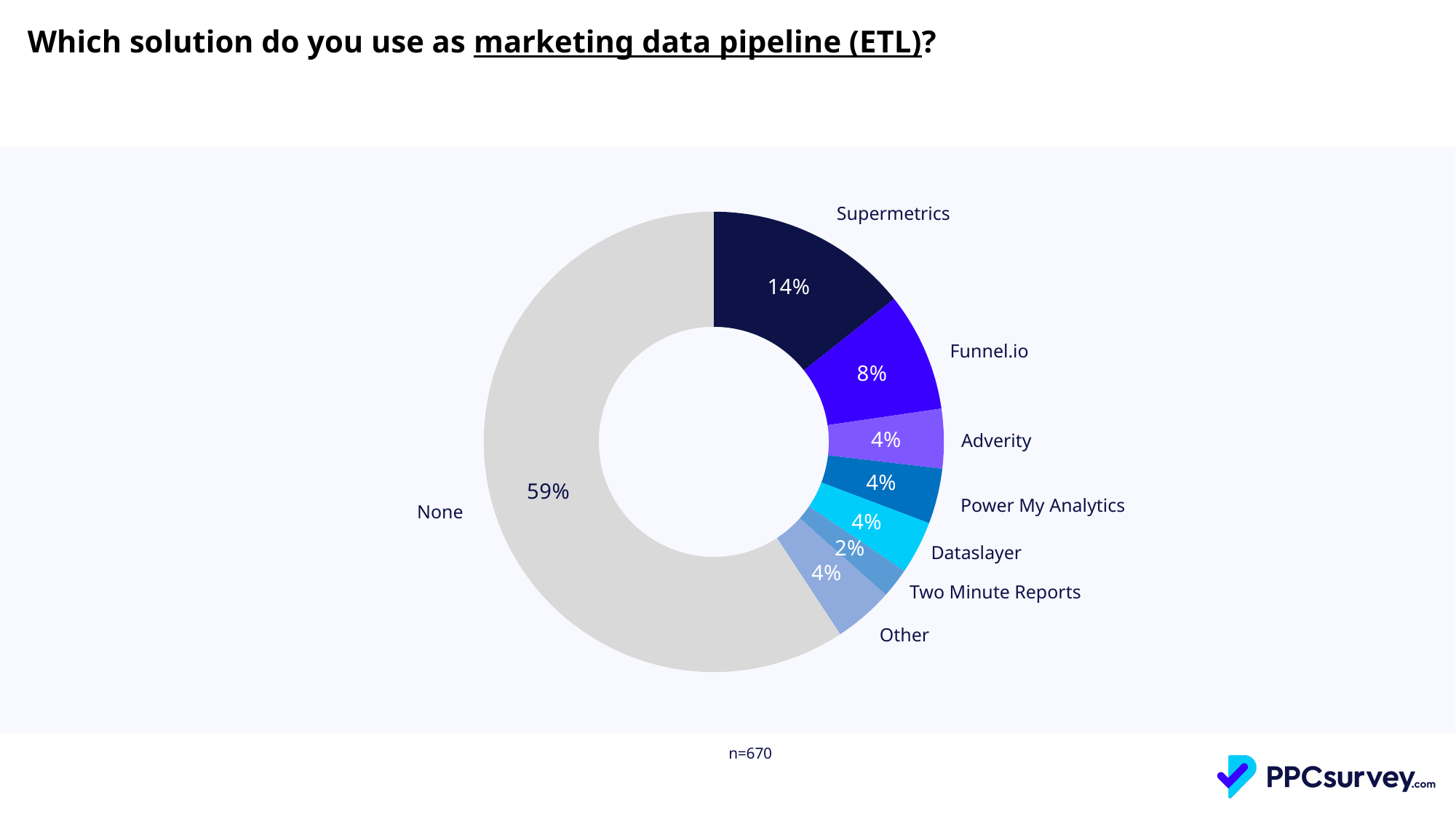
Which category has the largest share of the chart? None What share of respondents use Supermetrics as their marketing data pipeline (ETL)? 14% Which category has the smallest share of the chart? Two Minute Reports What share of respondents use Dataslayer? 4% What share of respondents use Funnel.io? 8% What percentage of respondents use Two Minute Reports? 2% What percentage of respondents answered None? 59% What is the sample size shown below the chart? n=670 Which has a larger share, Funnel.io or Adverity? Funnel.io What is the difference in percentage points between Supermetrics and Funnel.io? 6 How many categories are shown in the chart? 8 What kind of chart is shown on the slide? Pie chart (donut)